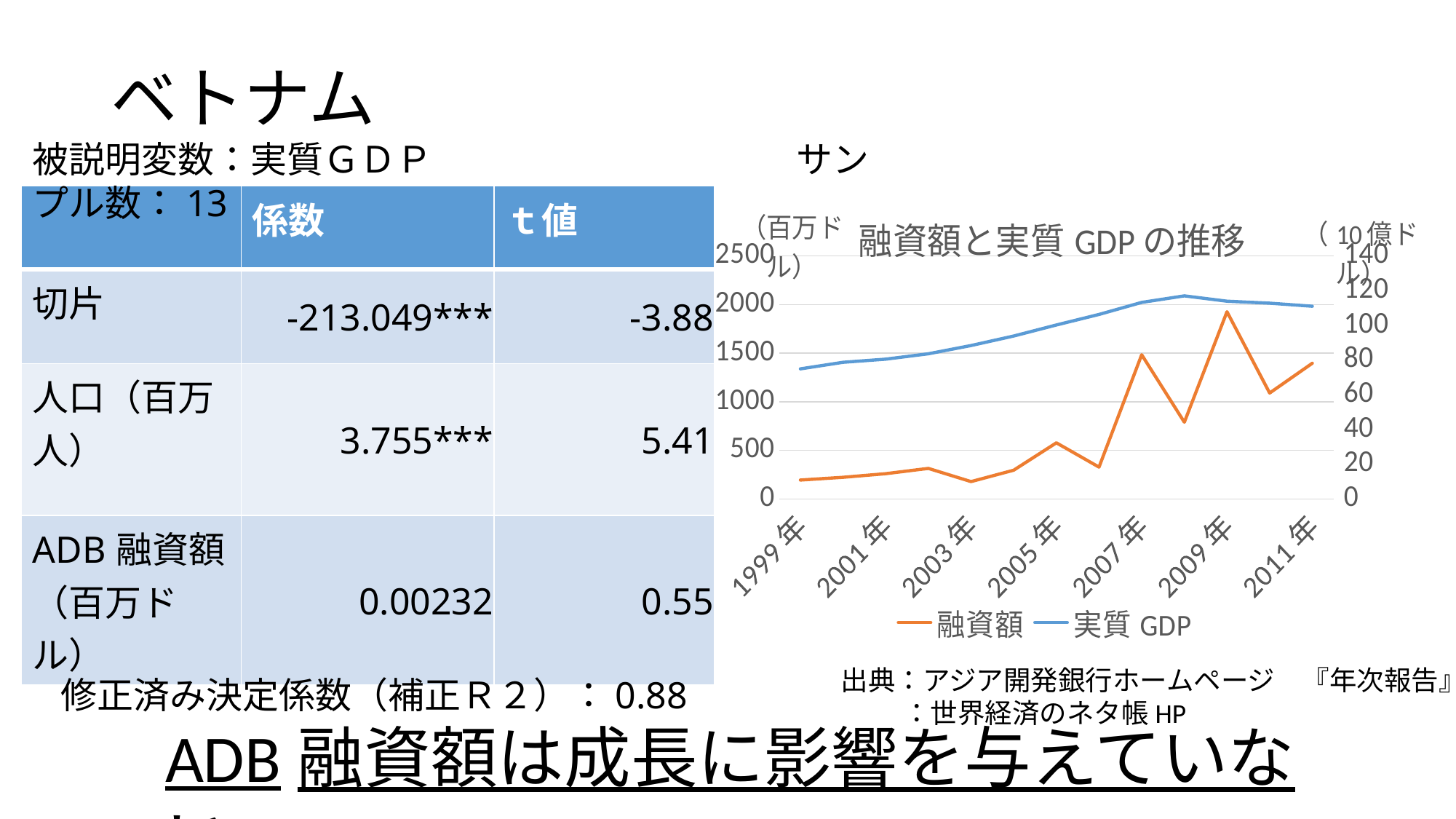
Is the value of 実質GDP in 1999年 greater or less than 60 on the right axis? greater Which series is drawn in orange? 融資額 What is the title of the chart? 融資額と実質GDPの推移 Is the value of 融資額 in 1999年 greater or less than 500? less How many year labels are shown on the x axis of the chart? 7 What kind of chart is shown on the slide? line chart Is the value of 融資額 in 2009年 greater or less than 1500? greater Does the 実質GDP series generally rise or fall from 1999年 to 2009年? rise Which is larger, the 融資額 value in 2009年 or in 2007年? 2009年 In which year does the 融資額 series reach its highest value? 2009年 How many series does the chart legend list? 2